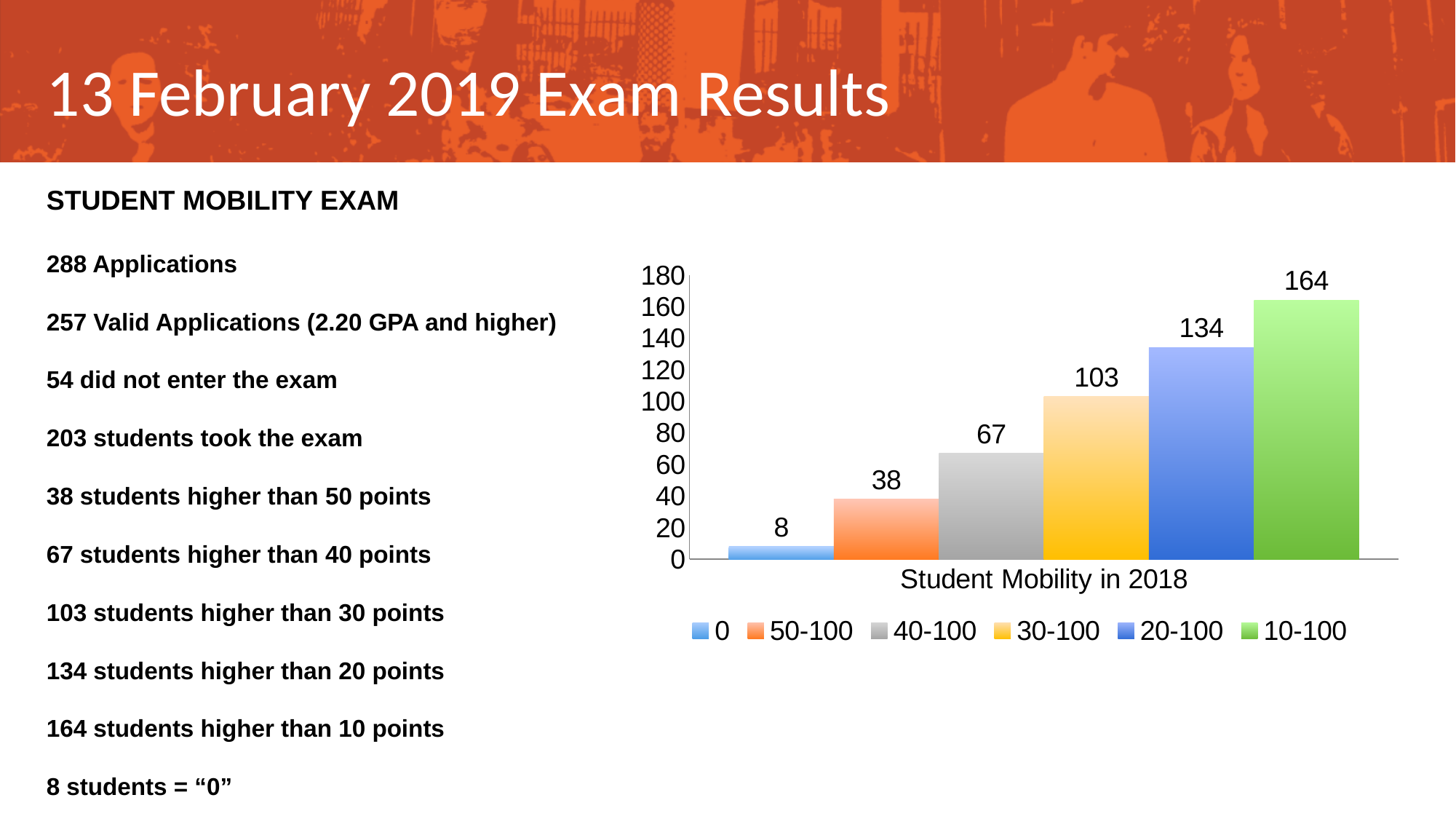
Which series has the lowest value in the chart? 0 What is the value for the 50-100 series in the chart? 38 How many series does the legend list? 6 Do the bar values rise or fall from left to right across the chart? Rise What kind of chart is shown on the slide? Bar chart What is the category label shown on the x axis of the chart? Student Mobility in 2018 Which is larger, the value for 20-100 or the value for 30-100? 20-100 What is the value for the 0 series in the chart? 8 Which series has the highest value in the chart? 10-100 What is the difference between the values for 10-100 and 20-100? 30 What is the value for the 30-100 series in the chart? 103 What is the difference between the values for 40-100 and 50-100? 29